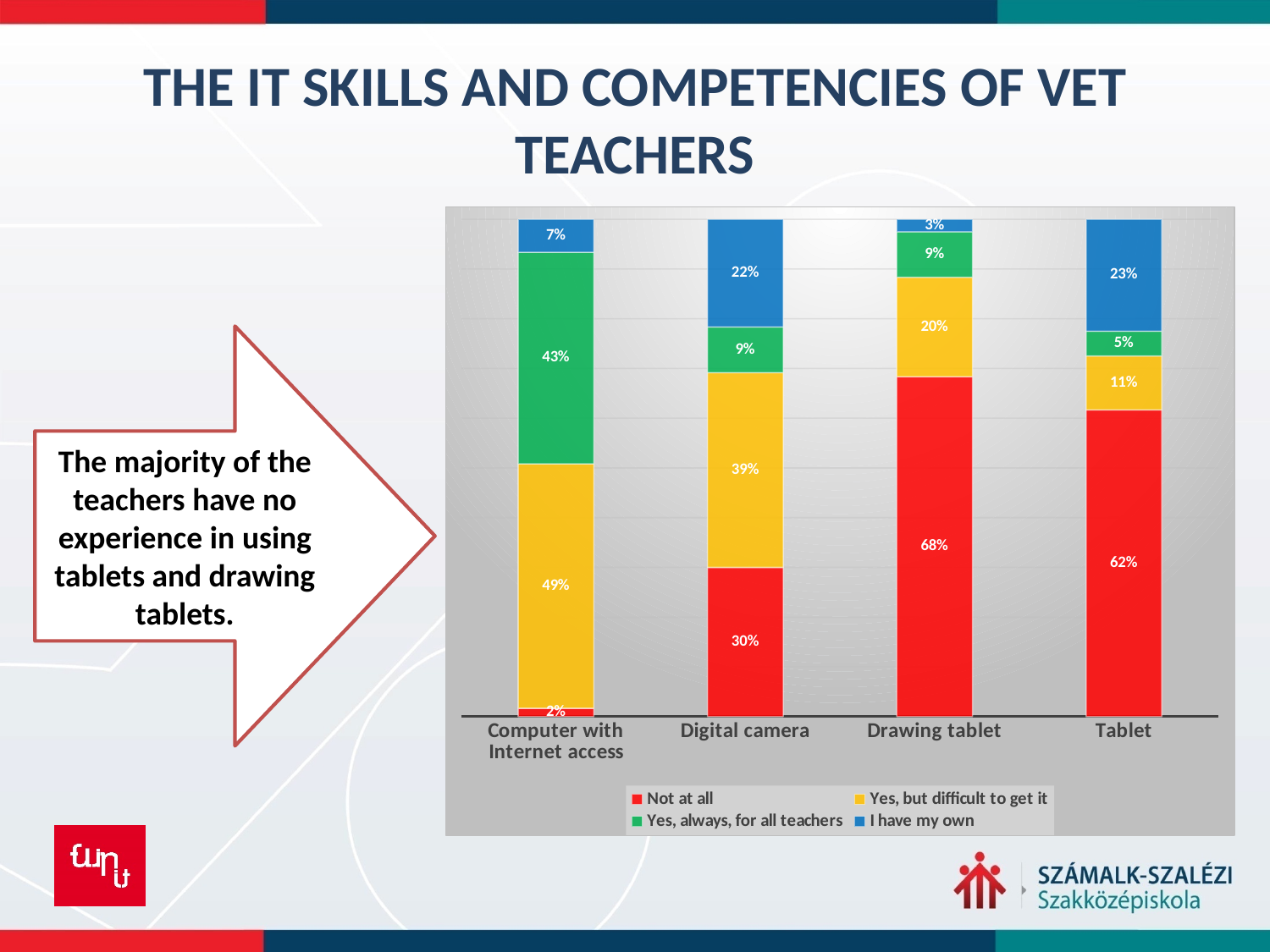
What kind of chart is shown on the slide? Stacked bar chart What is the 'I have my own' value for Tablet? 23% Which legend entry is shown in red? Not at all What is the 'Yes, always, for all teachers' value for Digital camera? 9% Which category has the lowest 'I have my own' value? Drawing tablet How many series does the chart's legend list? 4 Which category has the highest 'Not at all' value? Drawing tablet Which is larger: the 'Yes, but difficult to get it' value for Digital camera or for Tablet? Digital camera What is the 'Not at all' value for Drawing tablet? 68% What is the difference between the 'Not at all' values for Drawing tablet and Tablet? 6% How many categories are shown on the x axis of the chart? 4 What is the 'Yes, but difficult to get it' value for Computer with Internet access? 49%